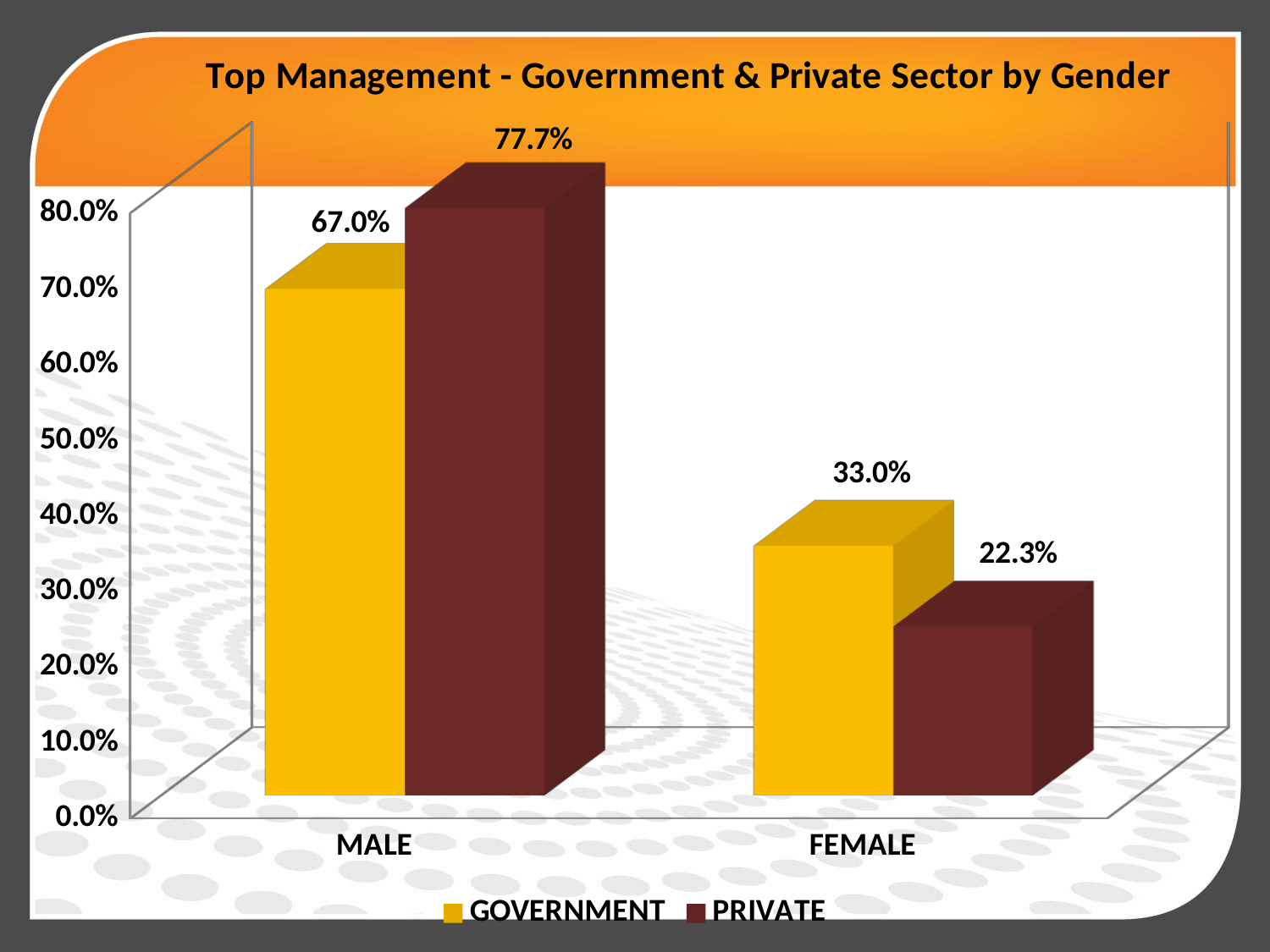
For Female, which is larger: Government or Private? Government What is the Private value for Male? 77.7% What is the Private value for Female? 22.3% How many categories are shown on the x axis? 2 What is the Government value for Male? 67.0% What is the difference between the Government and Private values for Female? 10.7% What is the Government value for Female? 33.0% What is the difference between the Private and Government values for Male? 10.7% Which category has the highest Private value? MALE Which category has the lowest Government value? FEMALE How many series does the legend list? 2 What kind of chart is shown on the slide? Bar chart